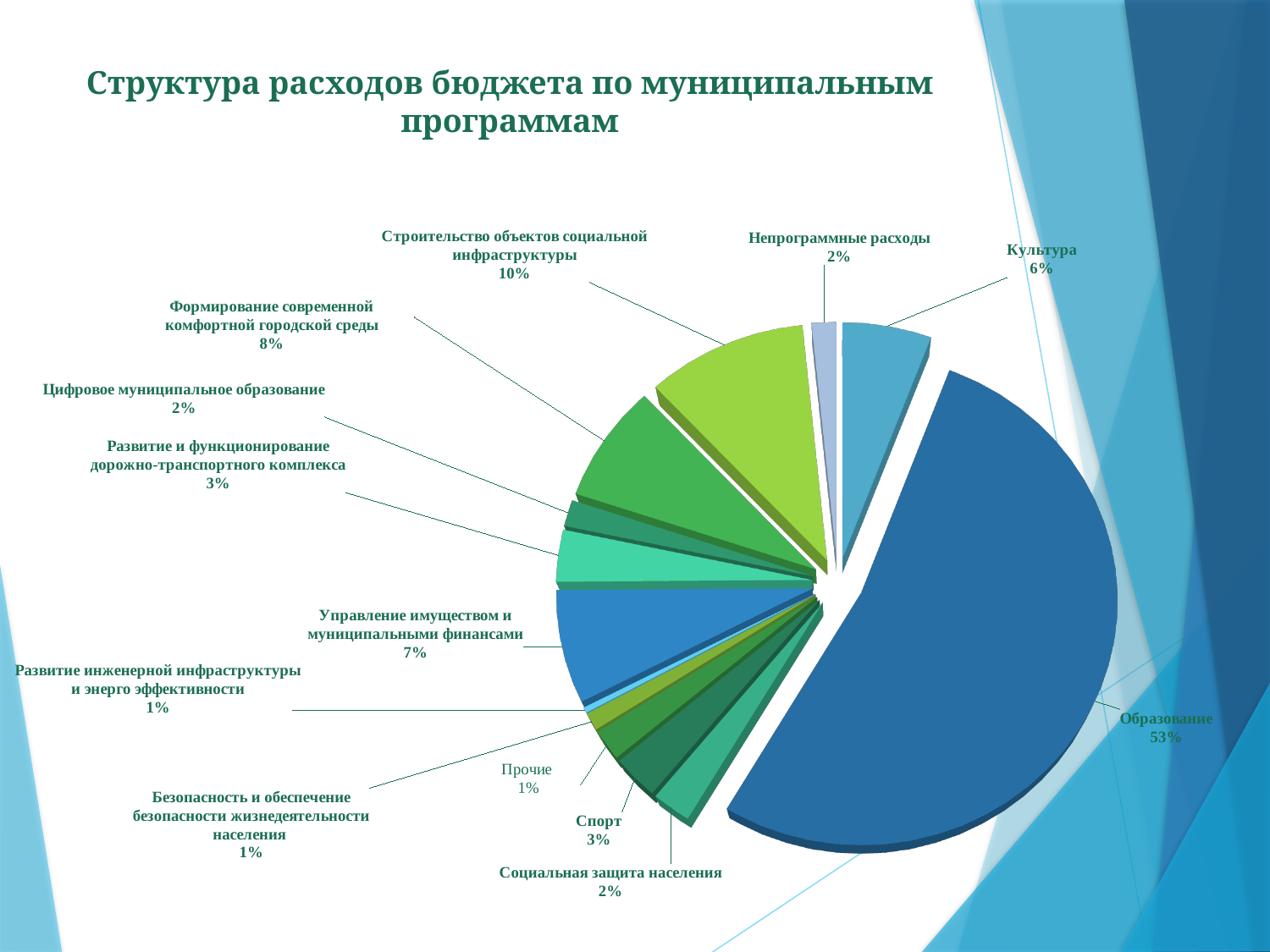
What is the value for Управление имуществом и муниципальными финансами? 7% What is the difference between the shares of Формирование современной комфортной городской среды and Управление имуществом и муниципальными финансами? 1% What is the title of the slide? Структура расходов бюджета по муниципальным программам What is the value shown for Строительство объектов социальной инфраструктуры? 10% Which category has the largest share of the pie? Образование What percentage is shown for Культура? 6% What is the difference between the shares of Образование and Строительство объектов социальной инфраструктуры? 43% Which is larger, the share for Культура or the share for Спорт? Культура What share of the pie does Образование account for? 53% What percentage is shown for Формирование современной комфортной городской среды? 8% What type of chart is shown on the slide? Pie chart How many categories are shown in the pie chart? 13